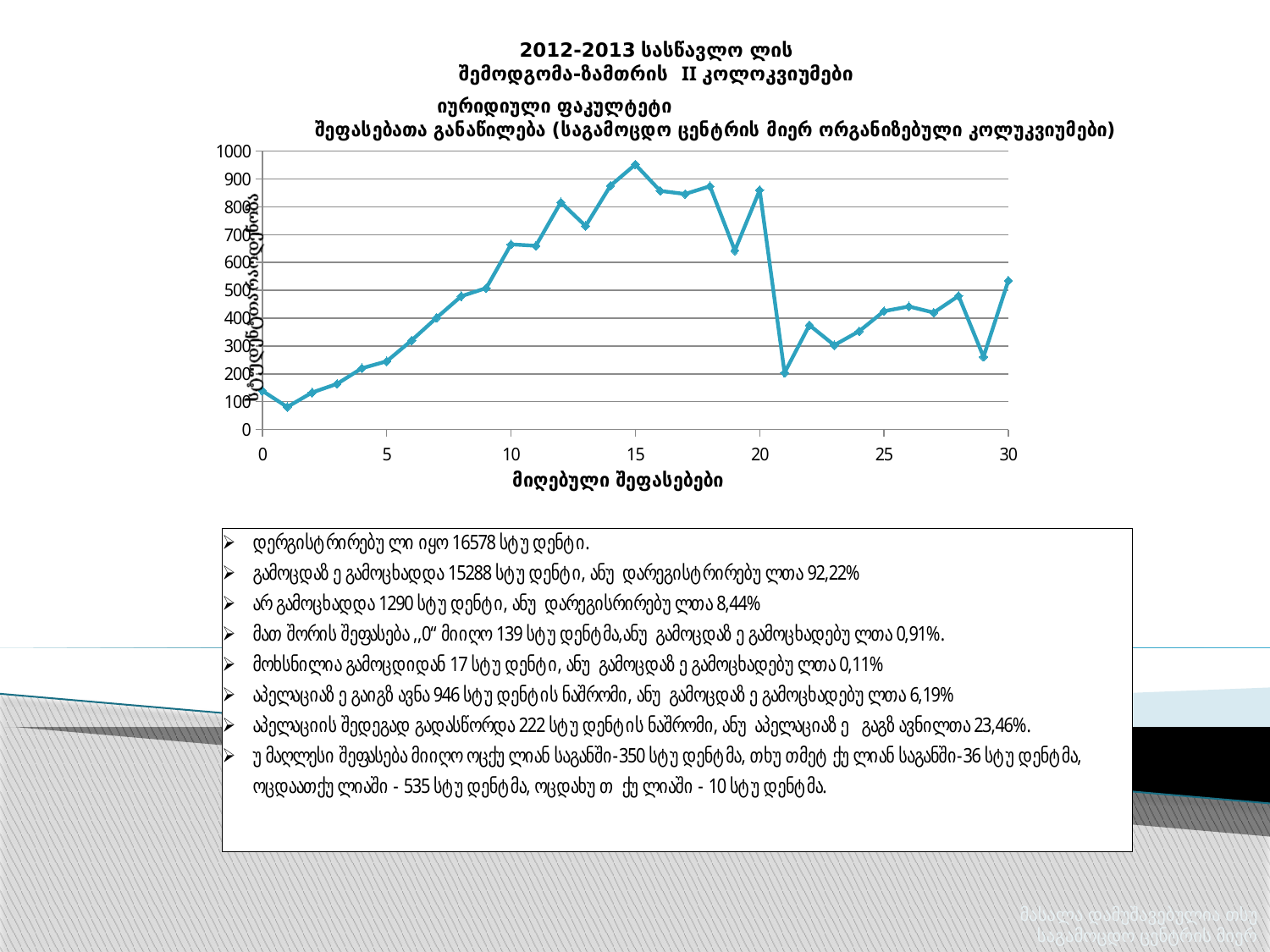
Is the value at score 1 greater or less than 100? less What kind of chart is shown on the slide? line chart Is the value at score 10 greater or less than 600? greater Is the value at score 15 greater or less than 900? greater At which score on the x axis does the line reach its lowest value? 1 Which has the larger value, score 5 or score 25? score 25 What is the label of the x axis? მიღებული შეფასებები Do the values generally rise or fall between score 1 and score 15? rise Which has the larger value, score 20 or score 21? score 20 At which score on the x axis does the line reach its highest value? 15